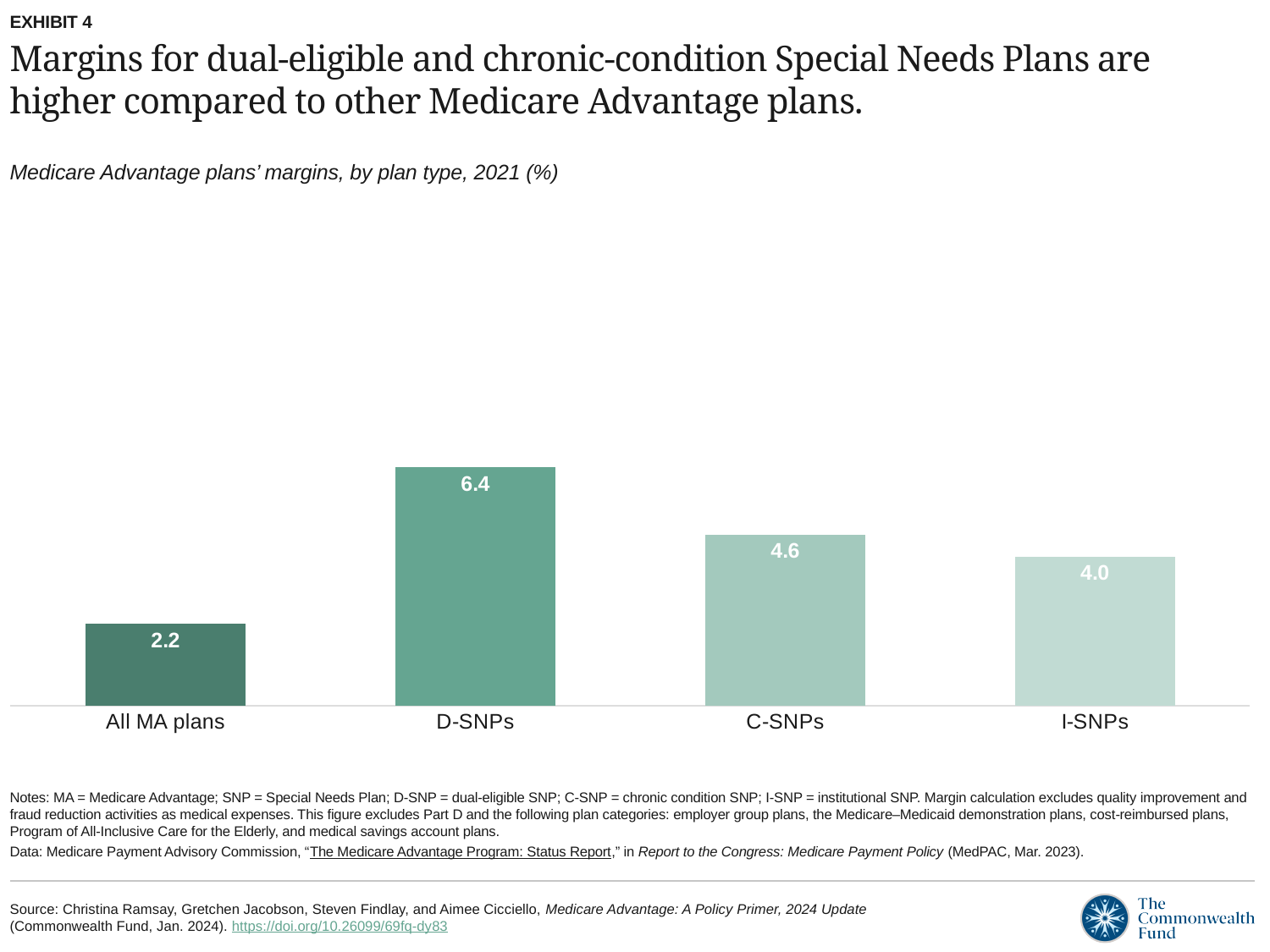
What is the margin for D-SNPs? 6.4 What is the margin for All MA plans? 2.2 What kind of chart is shown on the slide? Bar chart What is the margin for C-SNPs? 4.6 What is the difference between the margins for C-SNPs and I-SNPs? 0.6 What is the difference between the margins for D-SNPs and All MA plans? 4.2 How many plan types are shown in the chart? 4 Which plan type has the highest margin? D-SNPs What is the subtitle of the chart? Medicare Advantage plans' margins, by plan type, 2021 (%) Which has a larger margin, C-SNPs or I-SNPs? C-SNPs What is the margin for I-SNPs? 4.0 Which plan type has the lowest margin? All MA plans